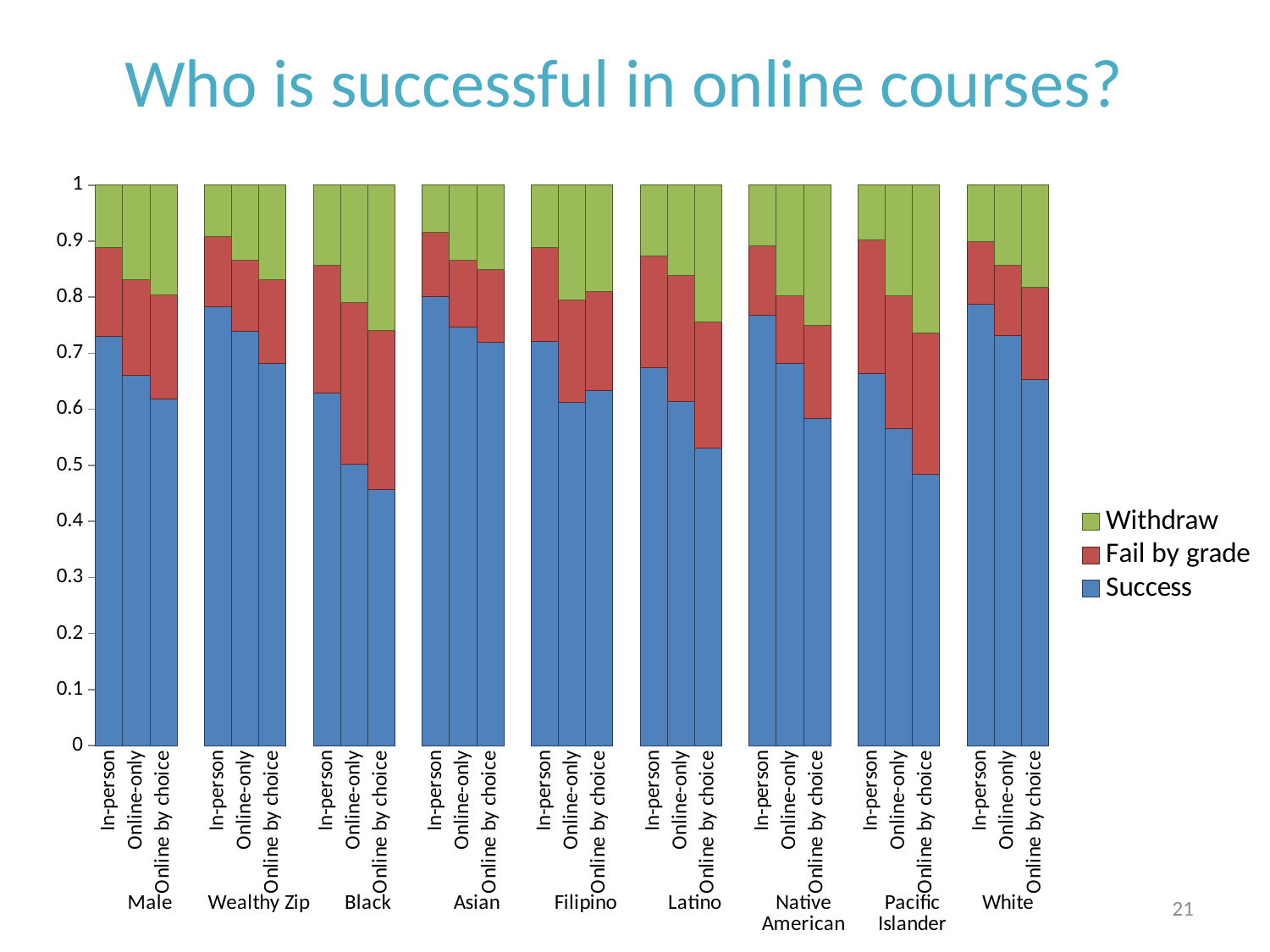
What is the total height of each stacked bar? 1 What are the three series listed in the legend? Withdraw, Fail by grade, Success Is the Success value for Male students in In-person courses greater or less than 0.7? greater What kind of chart is shown on the slide? Stacked bar chart Within the Black group, which course mode has the lowest Success value? Online by choice How many series does the legend list? 3 Which has the larger Success value: Asian Online by choice or Black Online by choice? Asian Online by choice How many demographic groups are shown along the x axis? 9 How many bars are shown for each demographic group? 3 Is the Success value for Black students in Online by choice courses greater or less than 0.5? less Within the Male group, does the Success value rise or fall from In-person to Online-only to Online by choice? fall